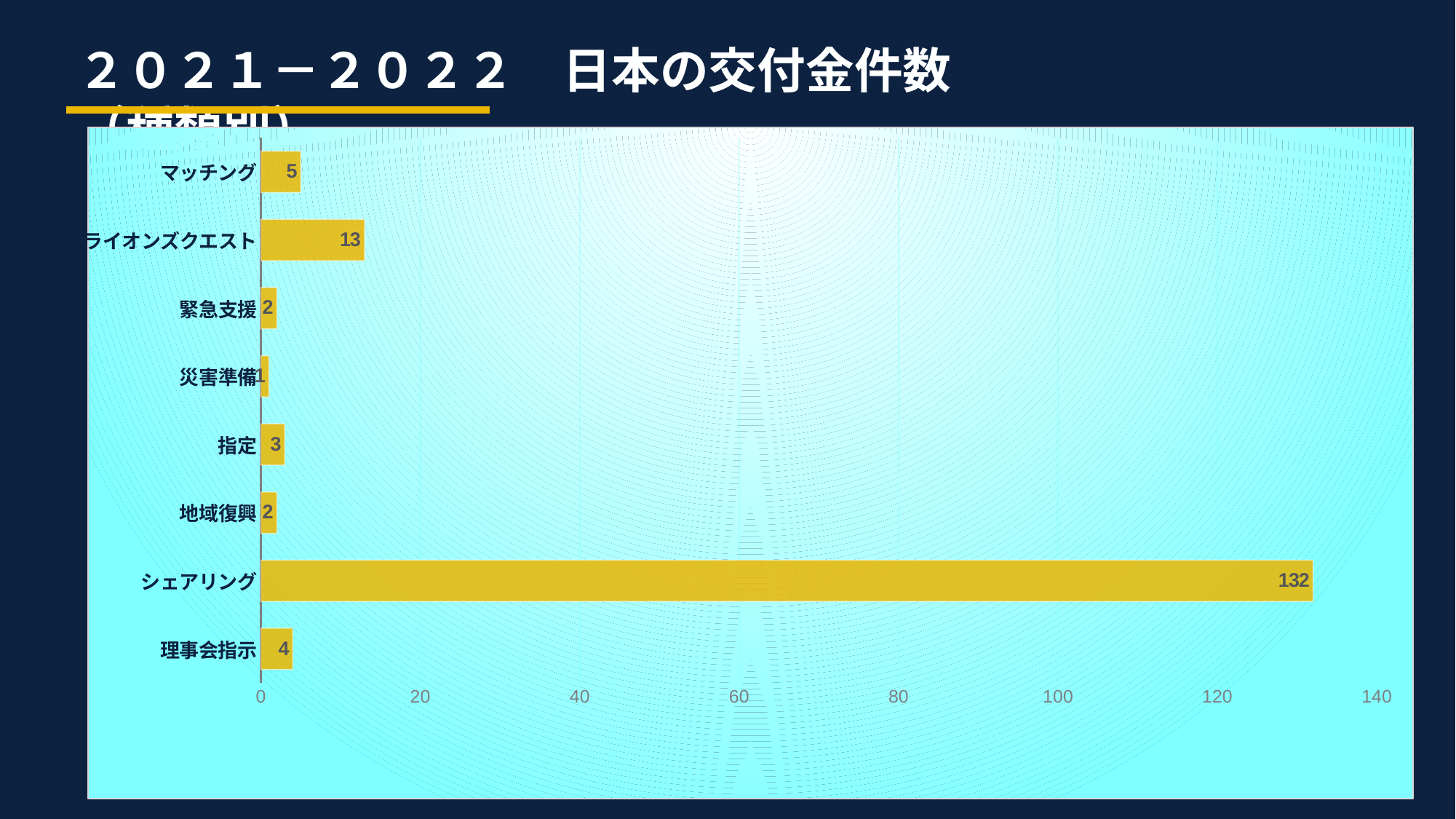
What is the difference between the values for シェアリング and ライオンズクエスト? 119 Which category has the lowest value? 災害準備 What is the value for ライオンズクエスト? 13 Which category has the highest value? シェアリング What is the value for 理事会指示? 4 What type of chart is shown on the slide? bar chart Which is larger, the value for マッチング or the value for 理事会指示? マッチング What is the value for マッチング? 5 What is the value for 指定? 3 What is the value for シェアリング? 132 How many categories are plotted in the chart? 8 Is the value for シェアリング greater or less than 120? greater